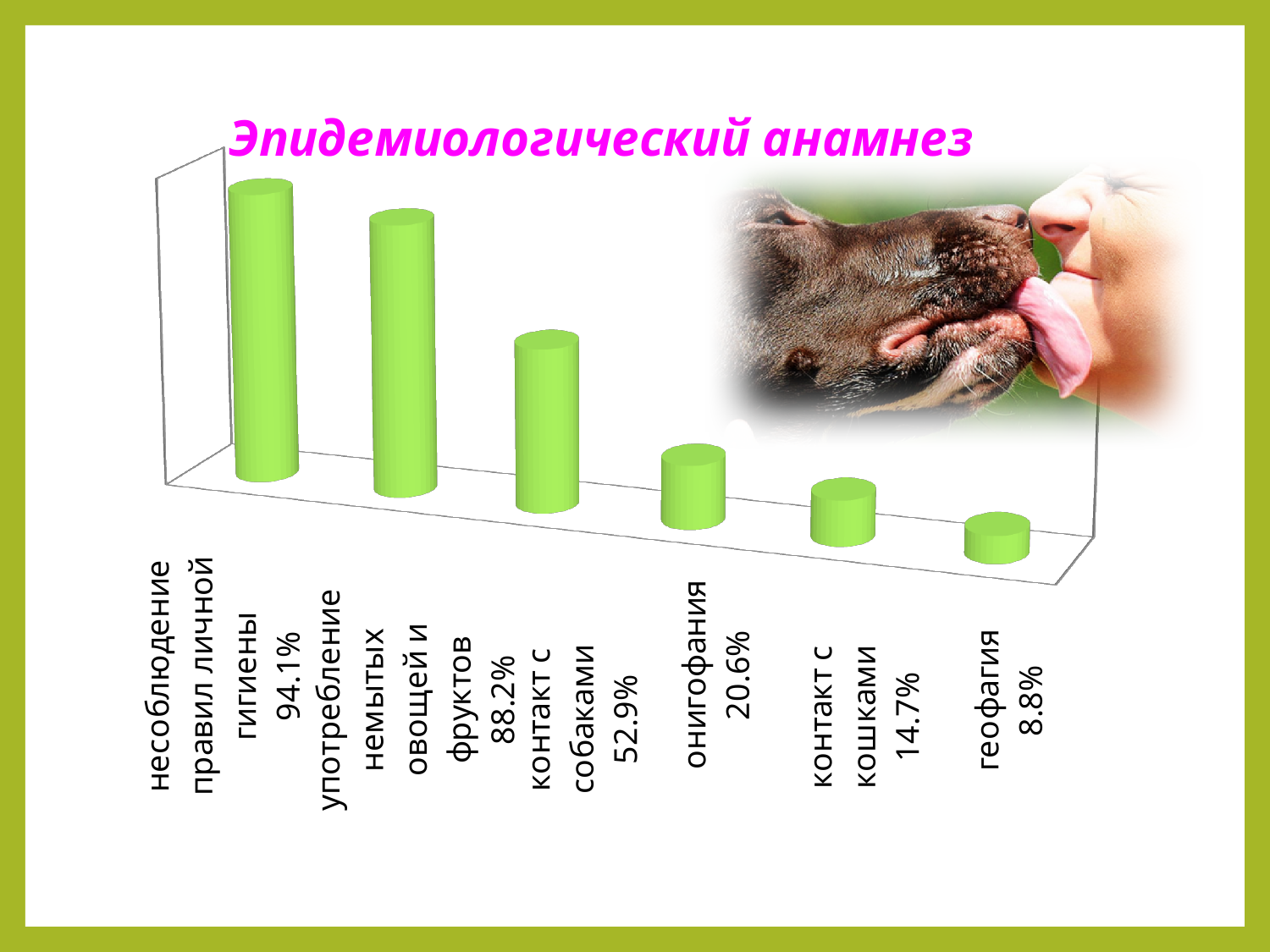
Which is larger, «контакт с кошками» or «контакт с собаками»? контакт с собаками How many categories are shown in the chart? 6 What value is shown for «контакт с собаками»? 52.9% What value is shown for «несоблюдение правил личной гигиены»? 94.1% Which category has the lowest value? геофагия What is the difference between «контакт с собаками» and «онигофания»? 32.3% What value is shown for «геофагия»? 8.8% What kind of chart is shown on the slide? bar chart What value is shown for «онигофания»? 20.6% Which category has the highest value? несоблюдение правил личной гигиены What is the difference between «несоблюдение правил личной гигиены» and «употребление немытых овощей и фруктов»? 5.9% What is the title of the slide? Эпидемиологический анамнез